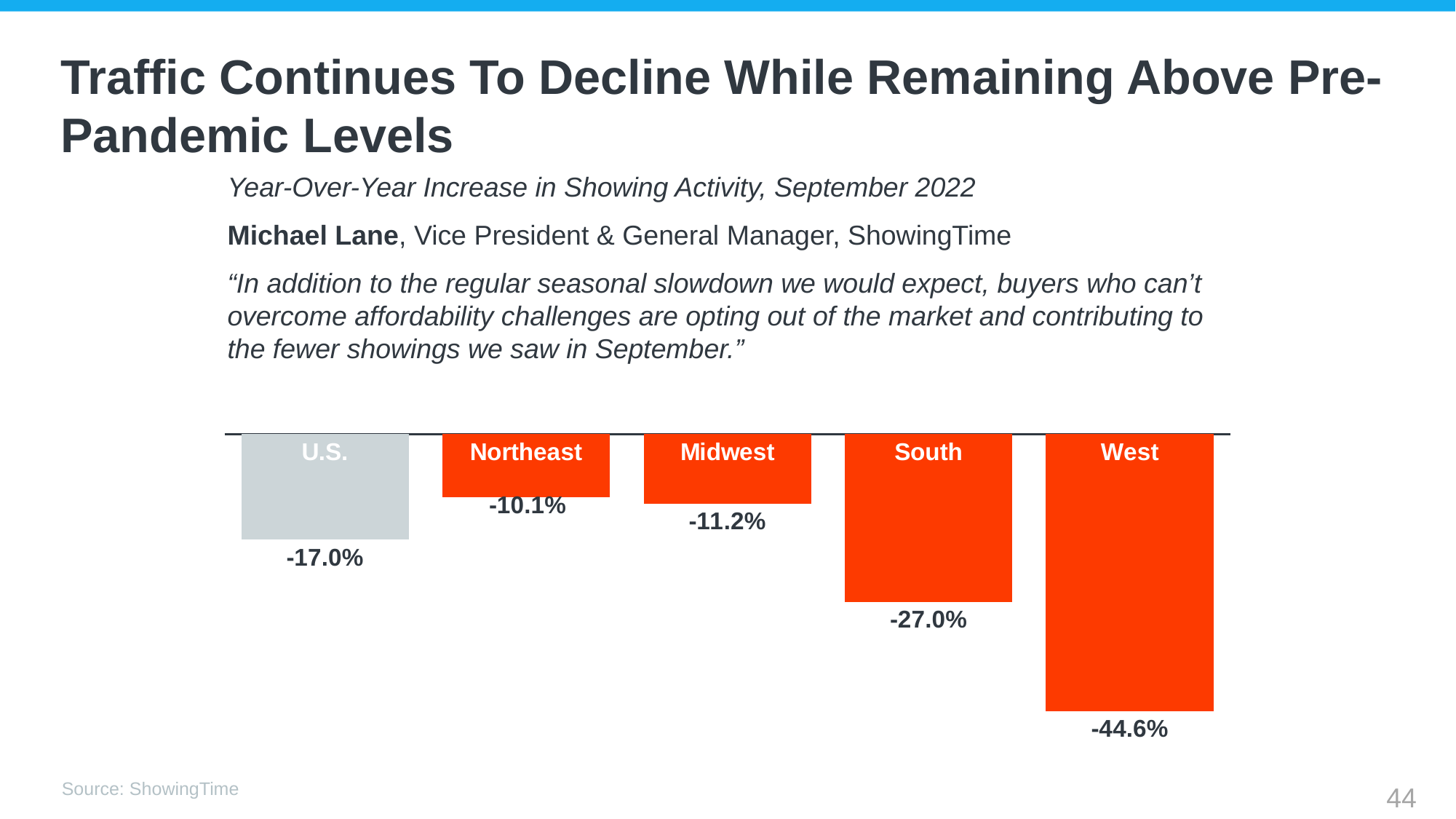
Which region shows the smallest decline in showing activity? Northeast What is the difference between the U.S. value and the Northeast value? 6.9 percentage points What is the value shown for the South? -27.0% What is the value shown for the Midwest? -11.2% What is the year-over-year change in showing activity for the West? -44.6% What value is shown for the U.S. bar? -17.0% What type of chart is used on this slide? Bar chart Which has a larger decline, the South or the Midwest? South How many bars are shown in the chart? 5 Which bar is coloured grey rather than orange-red? U.S. By how many percentage points does the West's decline exceed the South's decline? 17.6 percentage points Which region shows the largest decline in showing activity? West